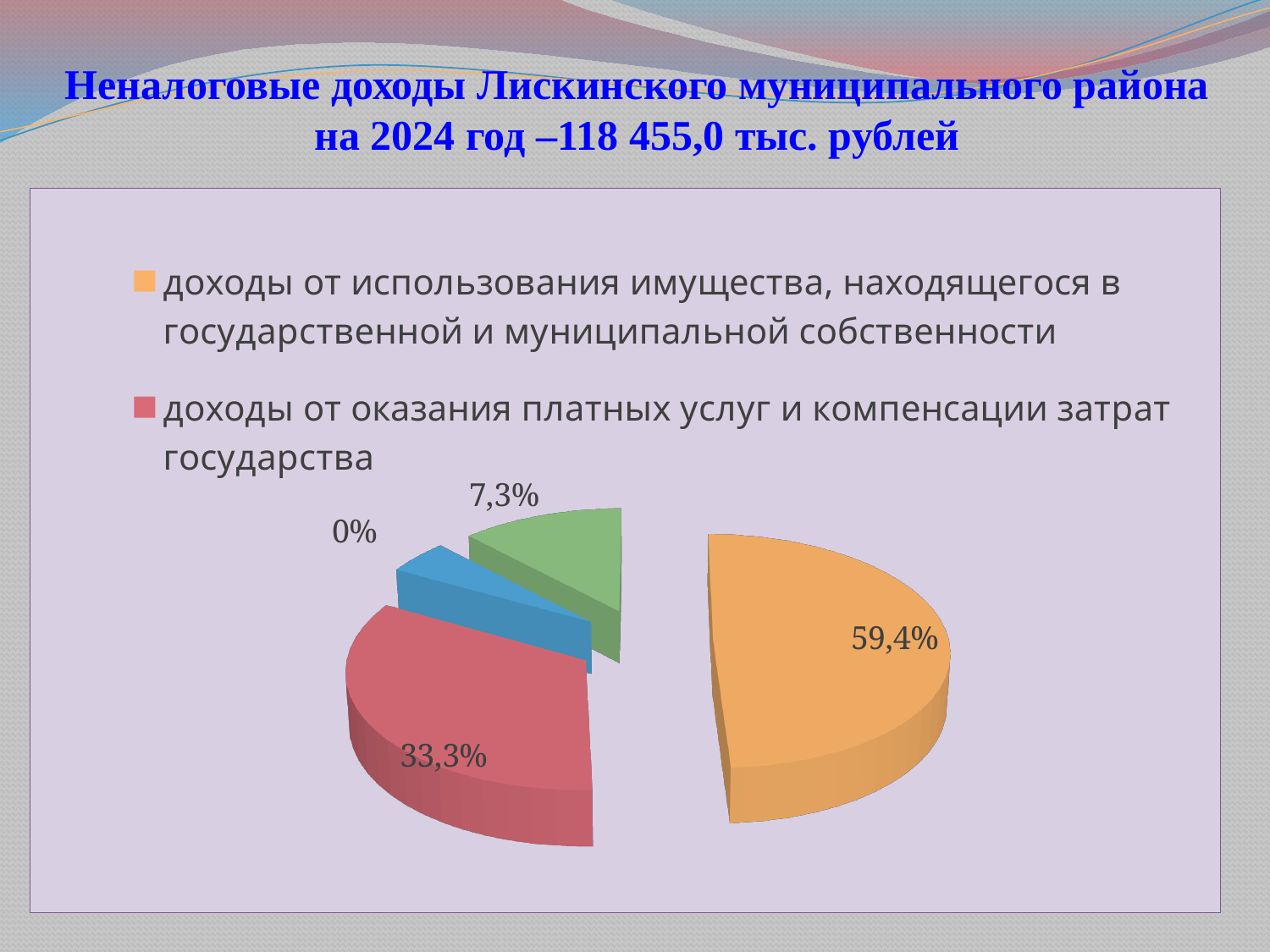
What percentage is shown for the blue slice of the pie? 0% What is the smallest percentage shown on the pie chart? 0% By how many percentage points does the share of 'доходы от использования имущества' exceed the share of 'доходы от оказания платных услуг и компенсации затрат государства'? 26,1 percentage points How many slices does the pie chart have? 4 Which is larger: the share of 'доходы от использования имущества' or the share of 'доходы от оказания платных услуг и компенсации затрат государства'? доходы от использования имущества What kind of chart is shown on the slide? pie chart What percentage is shown on the green slice of the pie? 7,3% Which category has the largest slice of the pie? доходы от использования имущества, находящегося в государственной и муниципальной собственности Is the share of 'доходы от использования имущества' greater or less than 50%? greater What percentage of the pie is 'доходы от использования имущества, находящегося в государственной и муниципальной собственности'? 59,4% According to the slide title, what is the total amount of non-tax revenue of the Liskinsky municipal district for 2024? 118 455,0 тыс. рублей What percentage of the pie is 'доходы от оказания платных услуг и компенсации затрат государства'? 33,3%